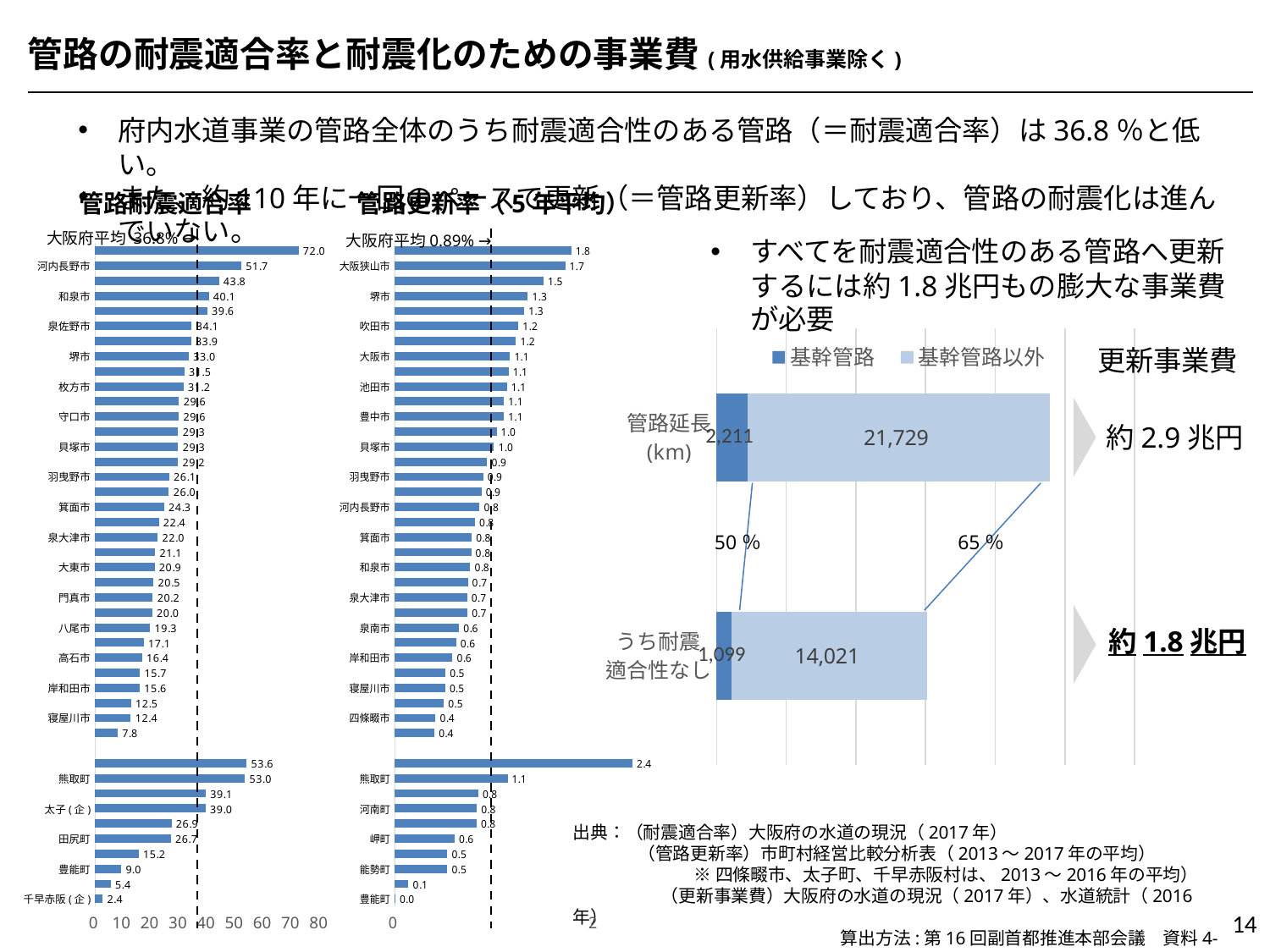
In the 管路延長 (km) stacked bar chart on the right, what is the 基幹管路以外 value for 管路延長 (km)? 21,729 In the 管路耐震適合率 chart on the left, what is the value for 河内長野市? 51.7 In the 管路延長 (km) stacked bar chart on the right, what is the total of the うち耐震適合性なし bar? 15,120 In the 管路更新率（5年平均） chart in the middle, what is the value for 豊能町? 0.0 How many series does the legend of the 管路延長 (km) stacked bar chart on the right list? 2 What kind of chart is the 管路延長 (km) chart on the right? Stacked bar chart In the 管路耐震適合率 chart on the left, which is larger, the value for 堺市 or the value for 八尾市? 堺市 In the 管路耐震適合率 chart on the left, what is the value for 千早赤阪(企)? 2.4 In the 管路耐震適合率 chart on the left, what is the difference between the values for 和泉市 and 岸和田市? 24.5 In the 管路更新率（5年平均） chart in the middle, what is the 大阪府平均 value shown? 0.89% In the 管路更新率（5年平均） chart in the middle, what is the value for 大阪狭山市? 1.7 In the 管路耐震適合率 chart on the left, what is the value for 寝屋川市? 12.4